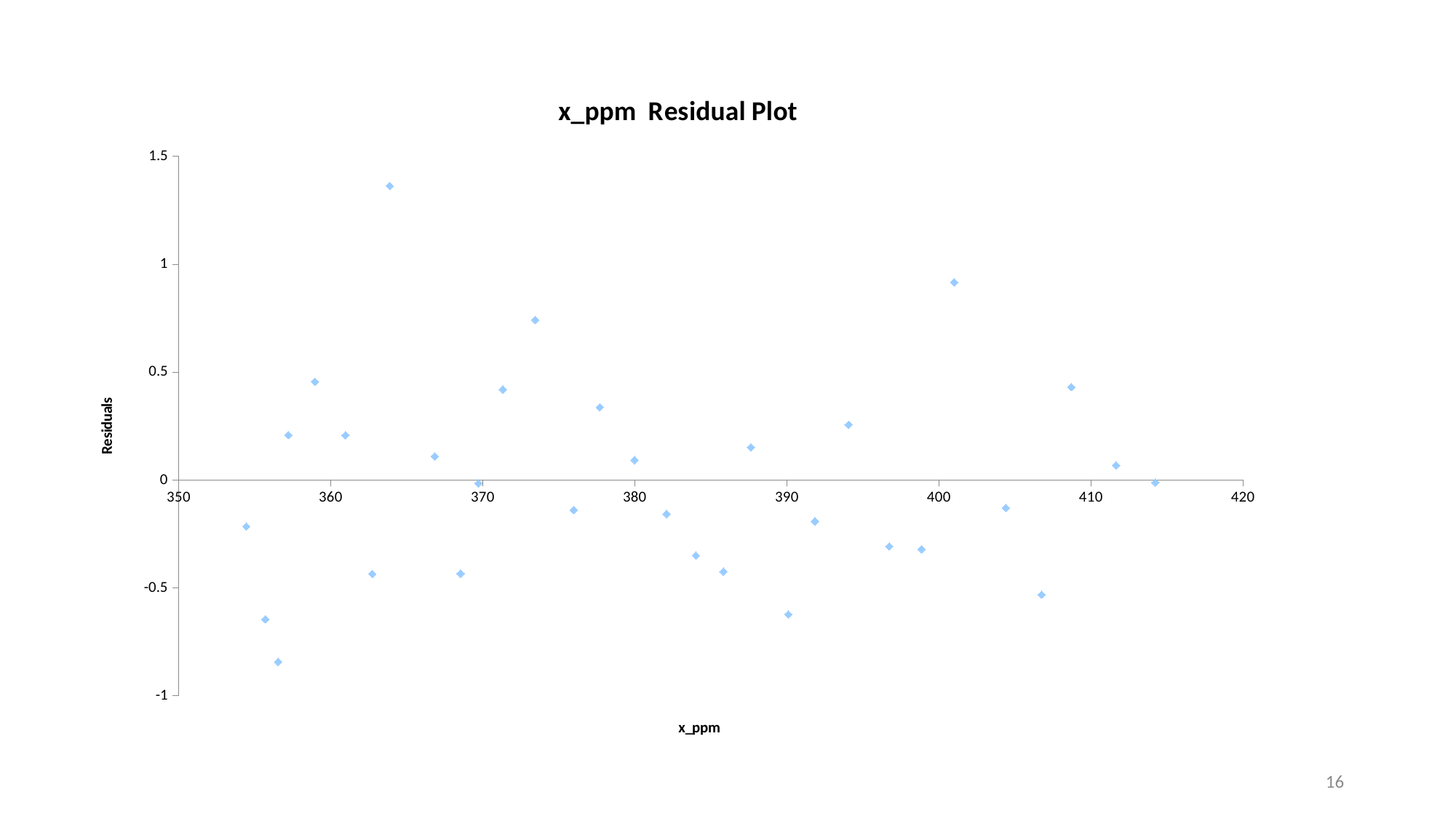
What is the maximum value shown on the vertical axis? 1.5 Is the lowest residual value plotted greater or less than -0.5? less What kind of chart is shown on the slide? Scatter plot Is the highest residual value plotted greater or less than 1? greater Is the residual for the point near x_ppm 401 greater or less than 0.5? greater What is the title of the chart? x_ppm Residual Plot Do the residuals show a clear rising or falling trend along the x axis, or no clear trend? No clear trend What is the label of the vertical axis? Residuals